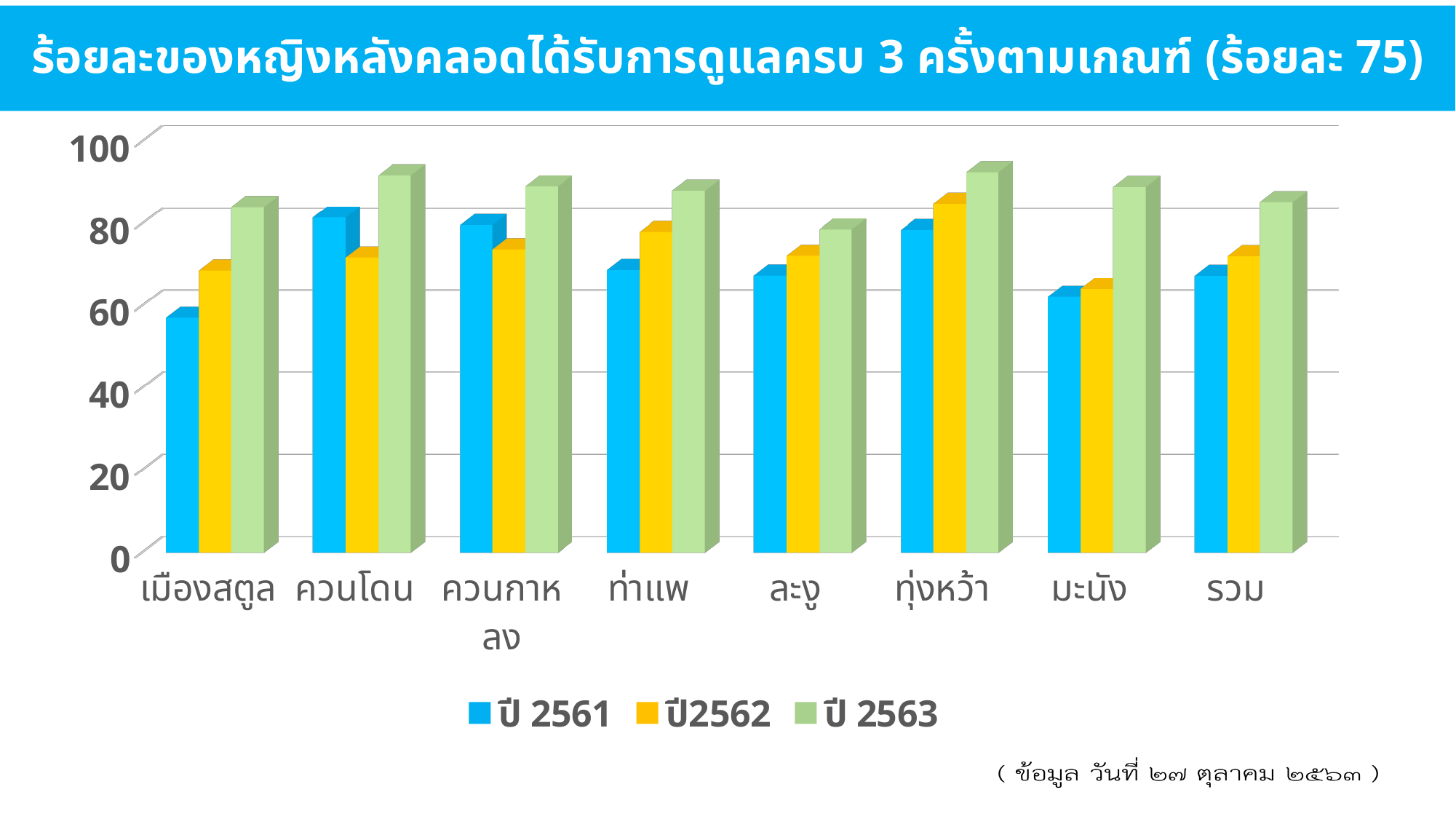
Which category has the lowest value for ปี 2563? ละงู Is the value for ควนโดน in ปี 2563 greater or less than 80? greater Which category has the lowest value for ปี 2561? เมืองสตูล For ควนโดน, which is larger: the value for ปี 2561 or the value for ปี2562? ปี 2561 Is the value for ทุ่งหว้า in ปี 2563 greater or less than 80? greater How many categories are shown on the x axis? 8 Is the value for เมืองสตูล in ปี 2561 greater or less than 60? less Which category has the highest value for ปี2562? ทุ่งหว้า What kind of chart is shown on the slide? bar chart For ท่าแพ, do the values rise or fall from ปี 2561 to ปี 2563? rise How many series does the legend list? 3